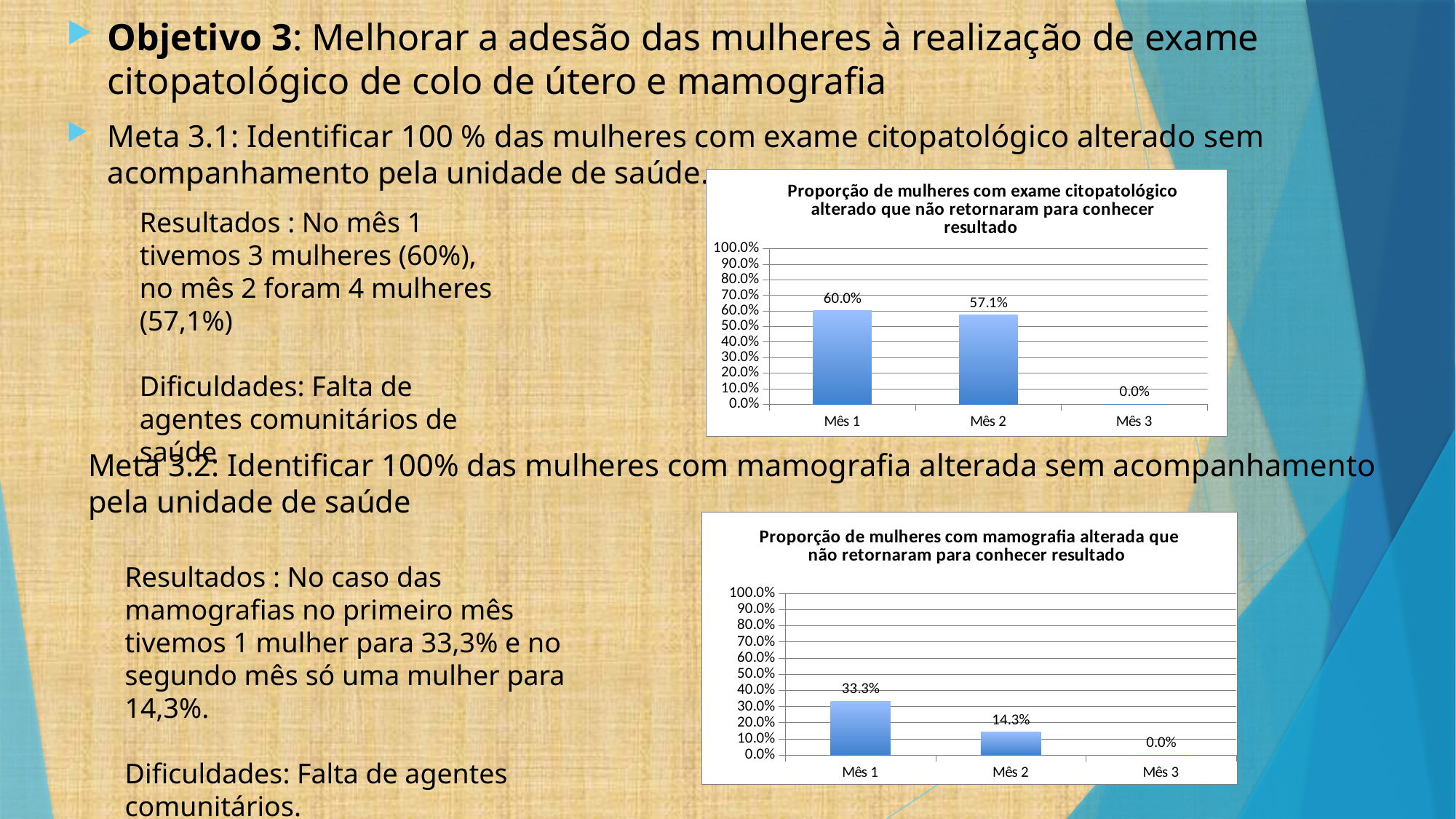
In the top chart (exame citopatológico), what is the value for Mês 3? 0.0% In the bottom chart (mamografia alterada), what is the difference between Mês 1 and Mês 2? 19.0% In the top chart (exame citopatológico), how many months are shown on the x axis? 3 In the top chart (Proporção de mulheres com exame citopatológico alterado que não retornaram para conhecer resultado), what is the value for Mês 1? 60.0% In the top chart (exame citopatológico), what is the difference between Mês 1 and Mês 2? 2.9% In the bottom chart (mamografia alterada), do the values rise or fall from Mês 1 to Mês 3? fall In the bottom chart (mamografia alterada), which month has the lowest value? Mês 3 In the bottom chart (mamografia alterada), what is the value for Mês 2? 14.3% In the top chart (exame citopatológico), which month has the highest value? Mês 1 In the bottom chart (Proporção de mulheres com mamografia alterada que não retornaram para conhecer resultado), what is the value for Mês 1? 33.3% In the top chart (exame citopatológico), what is the value for Mês 2? 57.1% What kind of chart is the bottom chart (mamografia alterada)? bar chart